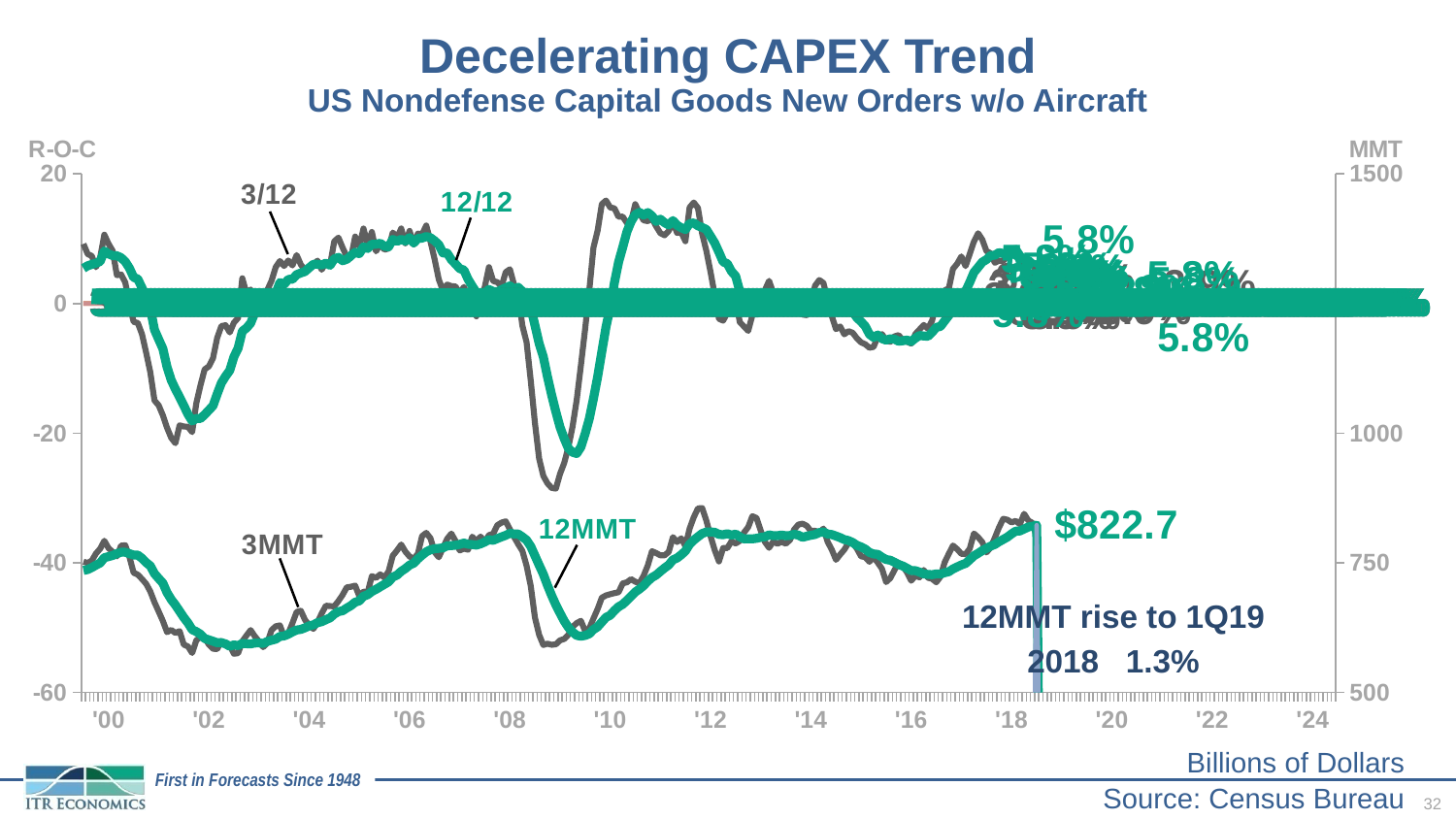
What growth rate is shown for 2018 in the annotation? 1.3% What is the source cited for the chart data? Census Bureau Is the 3/12 series trough around 2009 greater or less than -20 on the left axis? less What kind of chart is shown on the slide? line chart What is the highest value shown on the right (MMT) axis? 1500 Is the latest 12MMT value of $822.7 greater or less than 750 on the right axis? greater Which is higher for the 12MMT series: the value at '18 or the value at '16? '18 What is the title of the chart on the slide? Decelerating CAPEX Trend What is the latest labeled value of the 12MMT series? $822.7 What is the latest labeled value of the 12/12 series? 5.8% Does the 12MMT series rise or fall between '16 and '18? rise How many data series are labeled on the chart? 4